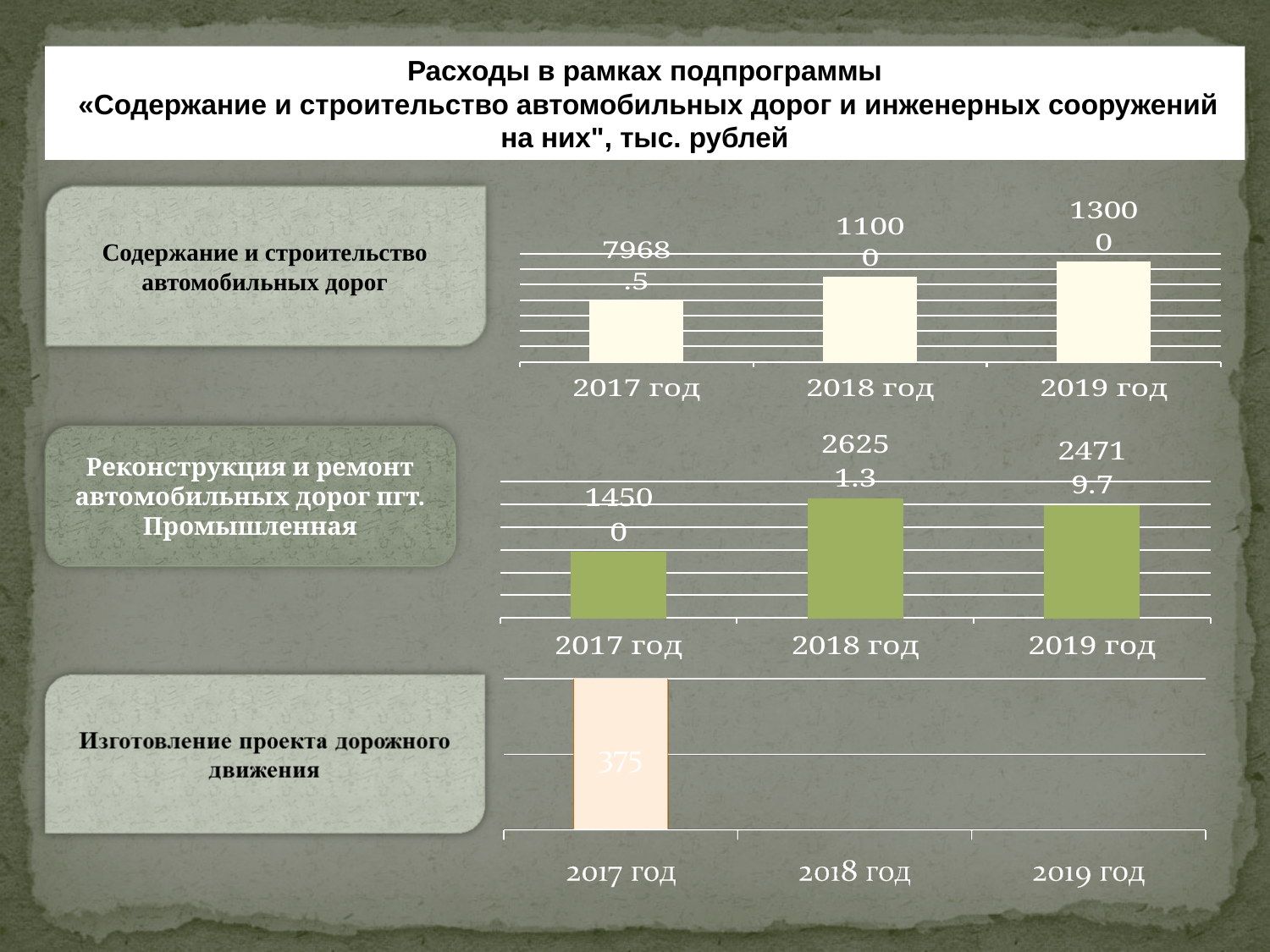
In the top chart (Содержание и строительство автомобильных дорог), what is the value for 2019 год? 13000 In the top chart (Содержание и строительство автомобильных дорог), what is the difference between the 2019 and 2018 values? 2000 In the middle chart (Реконструкция и ремонт автомобильных дорог пгт. Промышленная), which year has the lowest value? 2017 год In the middle chart (Реконструкция и ремонт автомобильных дорог пгт. Промышленная), which is larger, the value for 2018 год or 2019 год? 2018 год What type of chart is the middle chart (Реконструкция и ремонт автомобильных дорог пгт. Промышленная)? bar chart In the top chart (Содержание и строительство автомобильных дорог), what is the value for 2017 год? 7968.5 In the middle chart (Реконструкция и ремонт автомобильных дорог пгт. Промышленная), what is the value for 2018 год? 26251.3 In the top chart (Содержание и строительство автомобильных дорог), which year has the highest value? 2019 год How many year categories are shown on the x axis of the bottom chart (Изготовление проекта дорожного движения)? 3 In the middle chart (Реконструкция и ремонт автомобильных дорог пгт. Промышленная), what is the value for 2019 год? 24719.7 In the bottom chart (Изготовление проекта дорожного движения), what is the value for 2017 год? 375 In the top chart (Содержание и строительство автомобильных дорог), do the values rise or fall from 2017 to 2019? rise